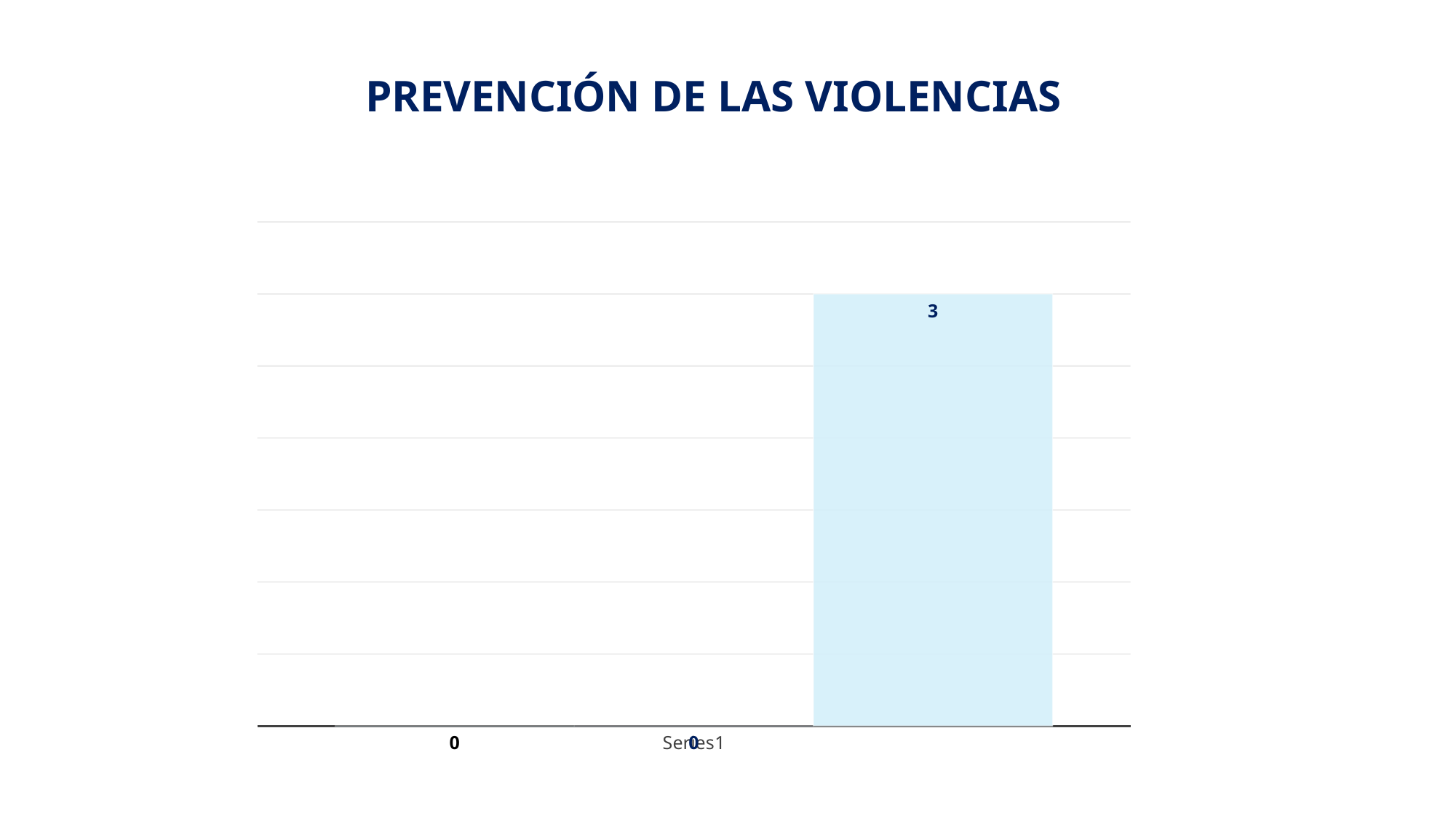
What kind of chart is shown on the slide? bar chart How many data labels are printed in the chart? 3 What is the value shown on the tallest bar in the chart? 3 What is the title of the chart? PREVENCIÓN DE LAS VIOLENCIAS How many of the labelled values in the chart are 0? 2 What label is printed on the horizontal axis of the chart? Series1 What is the lowest value labelled in the chart? 0 What is the highest value labelled in the chart? 3 What is the difference between the highest and lowest labelled values in the chart? 3